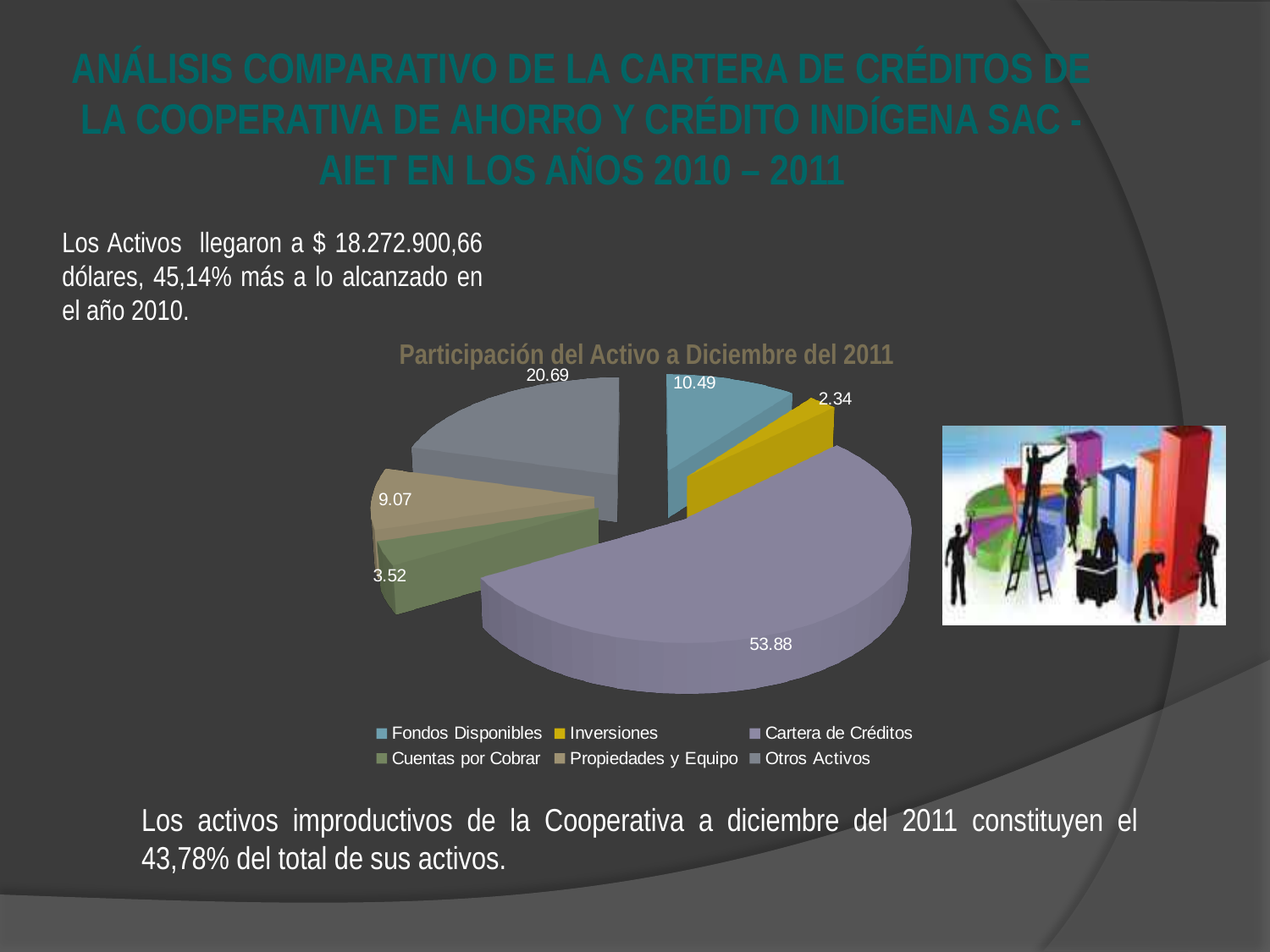
Which category has the largest slice of the pie chart? Cartera de Créditos Which category has the smallest slice of the pie chart? Inversiones What is the title of the chart? Participación del Activo a Diciembre del 2011 What is the value shown for Fondos Disponibles in the pie chart? 10.49 Which is larger in the pie chart, Otros Activos or Fondos Disponibles? Otros Activos What is the value shown for Otros Activos in the pie chart? 20.69 What is the value shown for Cartera de Créditos in the pie chart? 53.88 What is the value shown for Propiedades y Equipo in the pie chart? 9.07 What type of chart is shown on the slide? Pie chart How many categories does the legend of the pie chart list? 6 What is the value shown for Inversiones in the pie chart? 2.34 What is the difference between the values for Cartera de Créditos and Otros Activos? 33.19